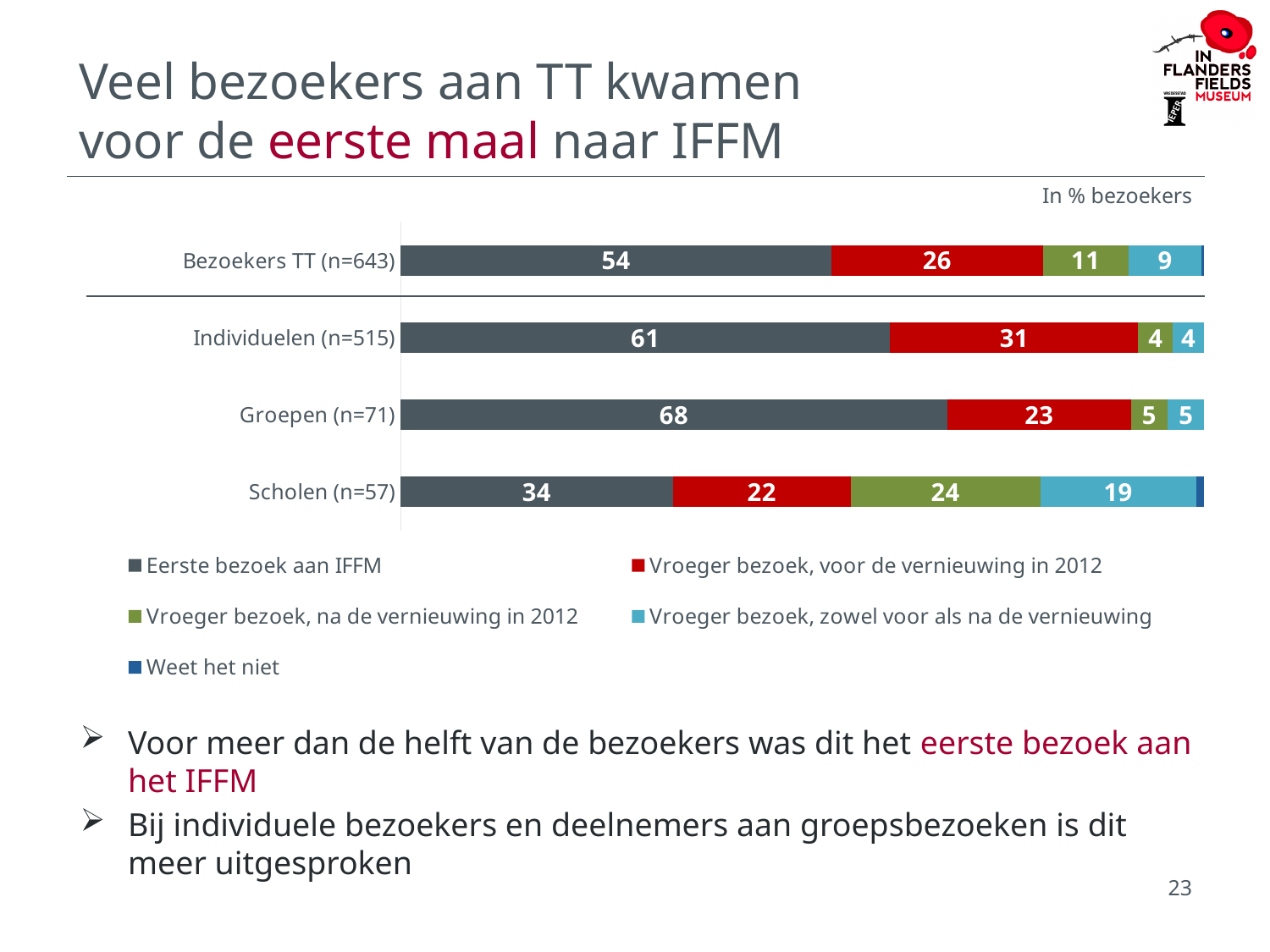
What is the value for 'Vroeger bezoek, na de vernieuwing in 2012' for Groepen (n=71)? 5 What unit note is shown above the chart? In % bezoekers How many categories (visitor groups) are plotted on the chart? 4 What is the value for 'Vroeger bezoek, voor de vernieuwing in 2012' for Individuelen (n=515)? 31 What is the difference between the 'Eerste bezoek aan IFFM' values for Groepen (n=71) and Scholen (n=57)? 34 Which category has the highest value for 'Eerste bezoek aan IFFM'? Groepen (n=71) Which category has the lowest value for 'Eerste bezoek aan IFFM'? Scholen (n=57) What is the value for 'Eerste bezoek aan IFFM' for Bezoekers TT (n=643)? 54 What type of chart is shown on the slide? Stacked bar chart What is the value for 'Vroeger bezoek, zowel voor als na de vernieuwing' for Scholen (n=57)? 19 Which is larger: the 'Vroeger bezoek, na de vernieuwing in 2012' value for Scholen (n=57) or for Bezoekers TT (n=643)? Scholen (n=57) How many series does the legend list? 5